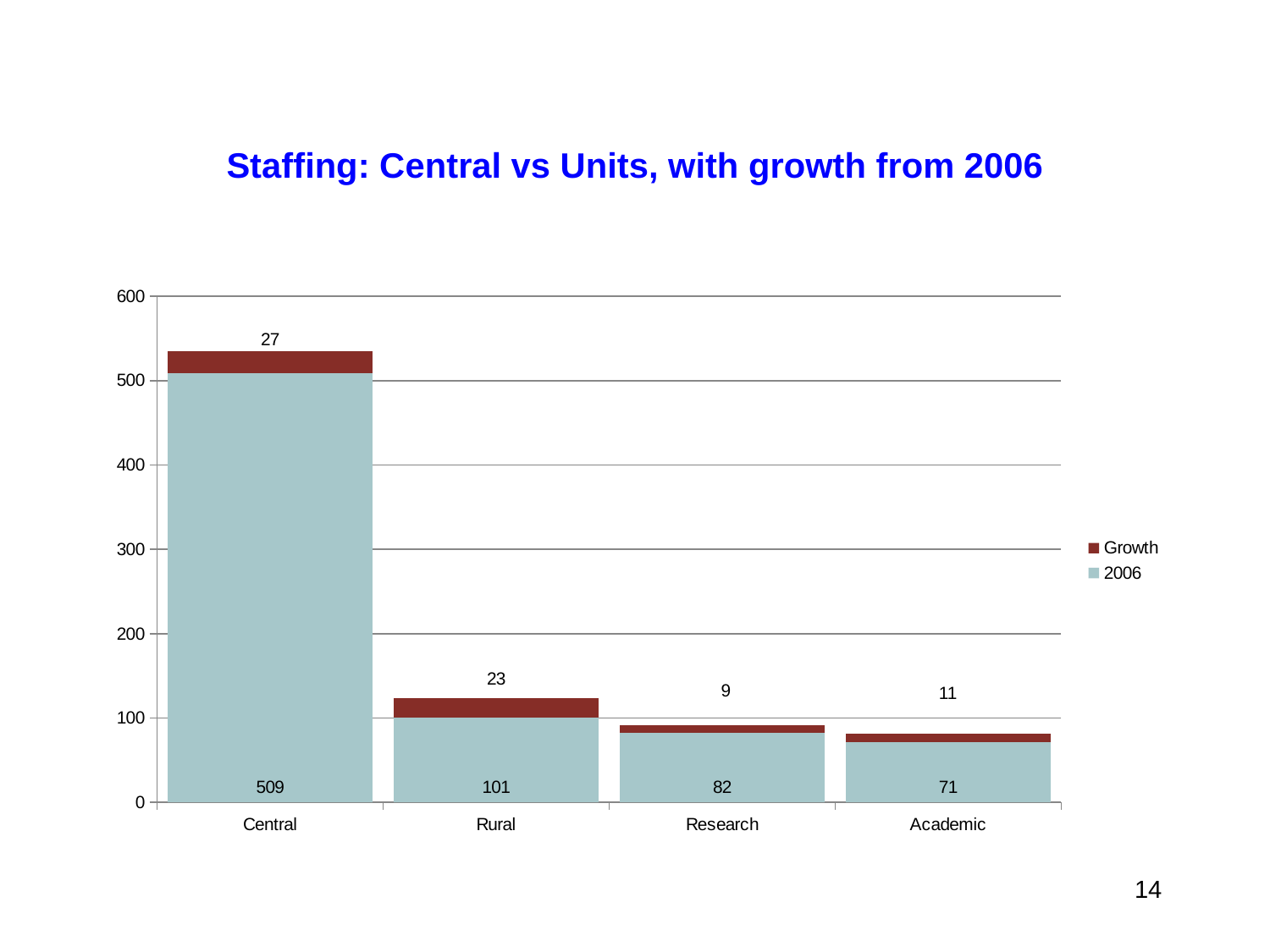
What is the Growth value for Academic? 11 Which category has the lowest Growth value? Research How many series does the legend list? 2 How many categories are shown on the x axis? 4 What is the Growth value for Rural? 23 What is the difference between the 2006 values for Rural and Academic? 30 Which category has the highest 2006 value? Central What is the 2006 value for Central? 509 What is the total of the stacked bar for Central? 536 What is the 2006 value for Research? 82 Which is larger, the Growth value for Central or the Growth value for Rural? Central What kind of chart is shown on the slide? Stacked bar chart